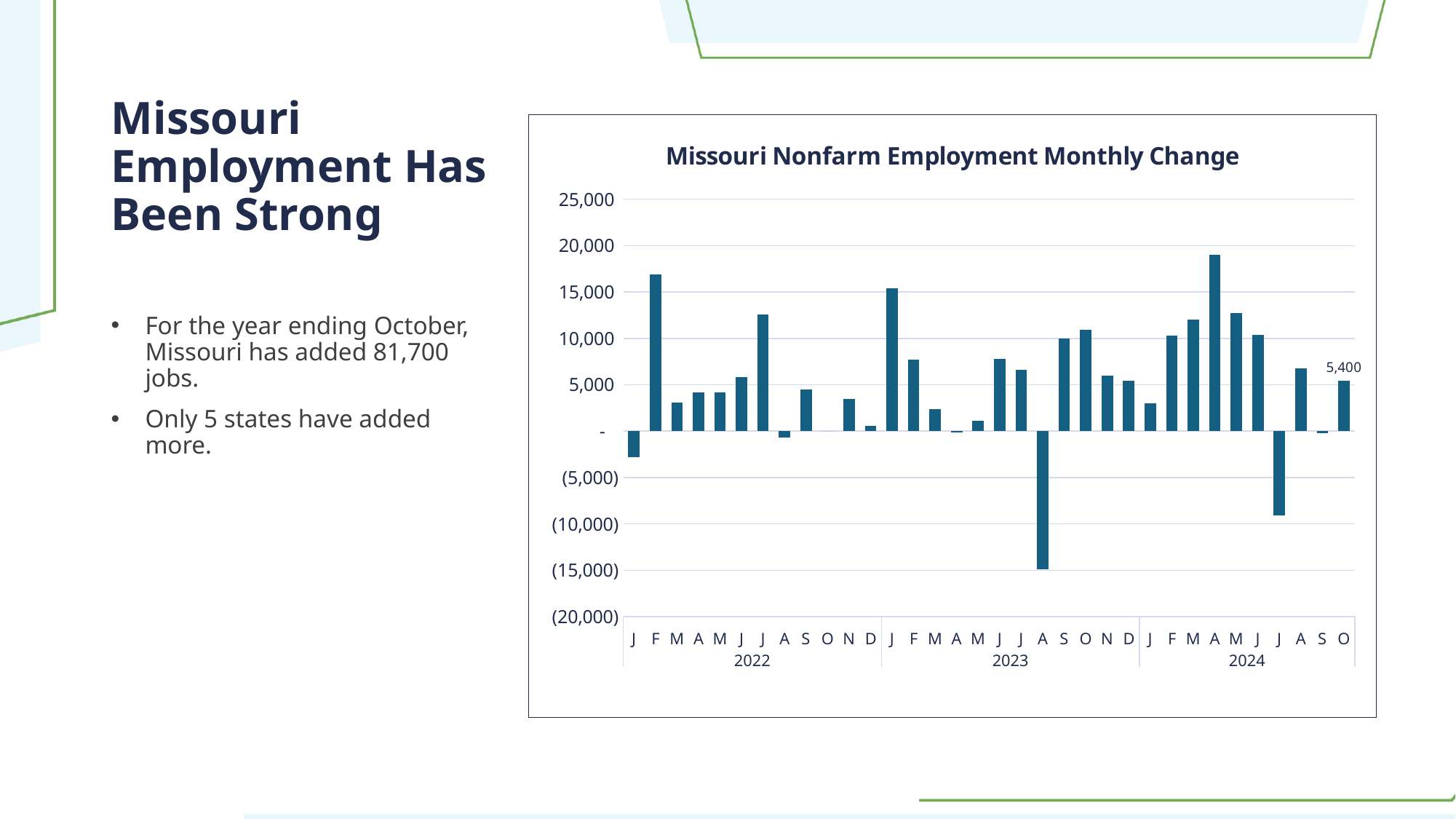
How many monthly bars are plotted in the chart? 34 Is the value for July 2024 greater or less than (5,000)? less Which is larger, the value for April 2024 or the value for February 2022? April 2024 Which month has the highest value in the chart? April 2024 Is the value for February 2022 greater or less than 15,000? greater What is the title of the chart? Missouri Nonfarm Employment Monthly Change What is the value for October 2024 in the chart? 5,400 Which month has the lowest value in the chart? August 2023 What kind of chart is shown on the slide? bar chart Is the value for August 2023 greater or less than (10,000)? less Which is larger, the value for January 2022 or the value for February 2022? February 2022